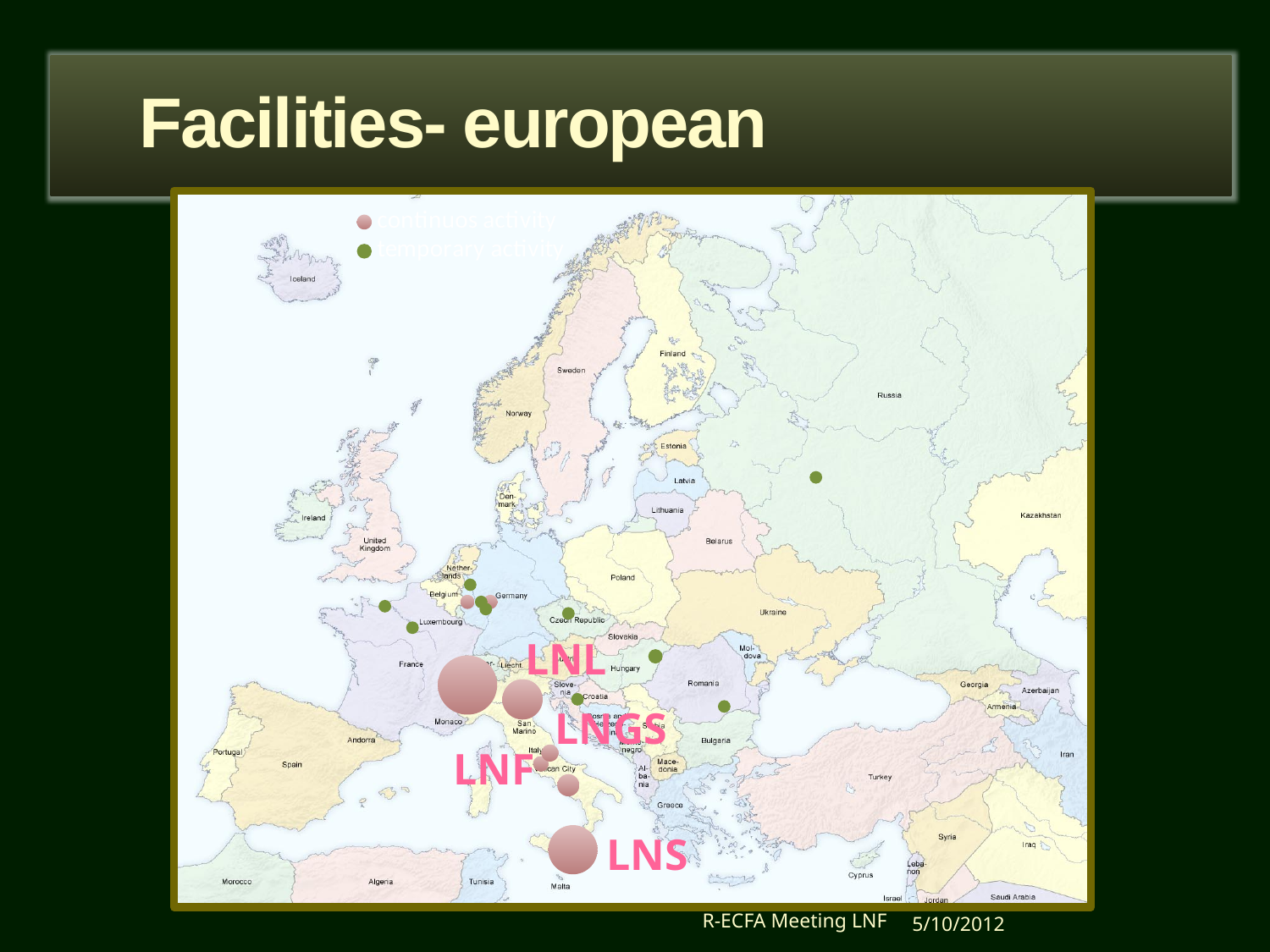
Which labelled facility is located furthest north on the map? LNL Which facility labels are printed on the map? LNL, LNGS, LNF, LNS How many facilities are labelled by name on the map? 4 How many entries does the legend on the map list? 2 Which legend entry do the green dots represent? temporary activity What is the title of the slide? Facilities- european What kind of chart is shown on the slide? A map with bubble markers Which labelled facility is located furthest south on the map? LNS